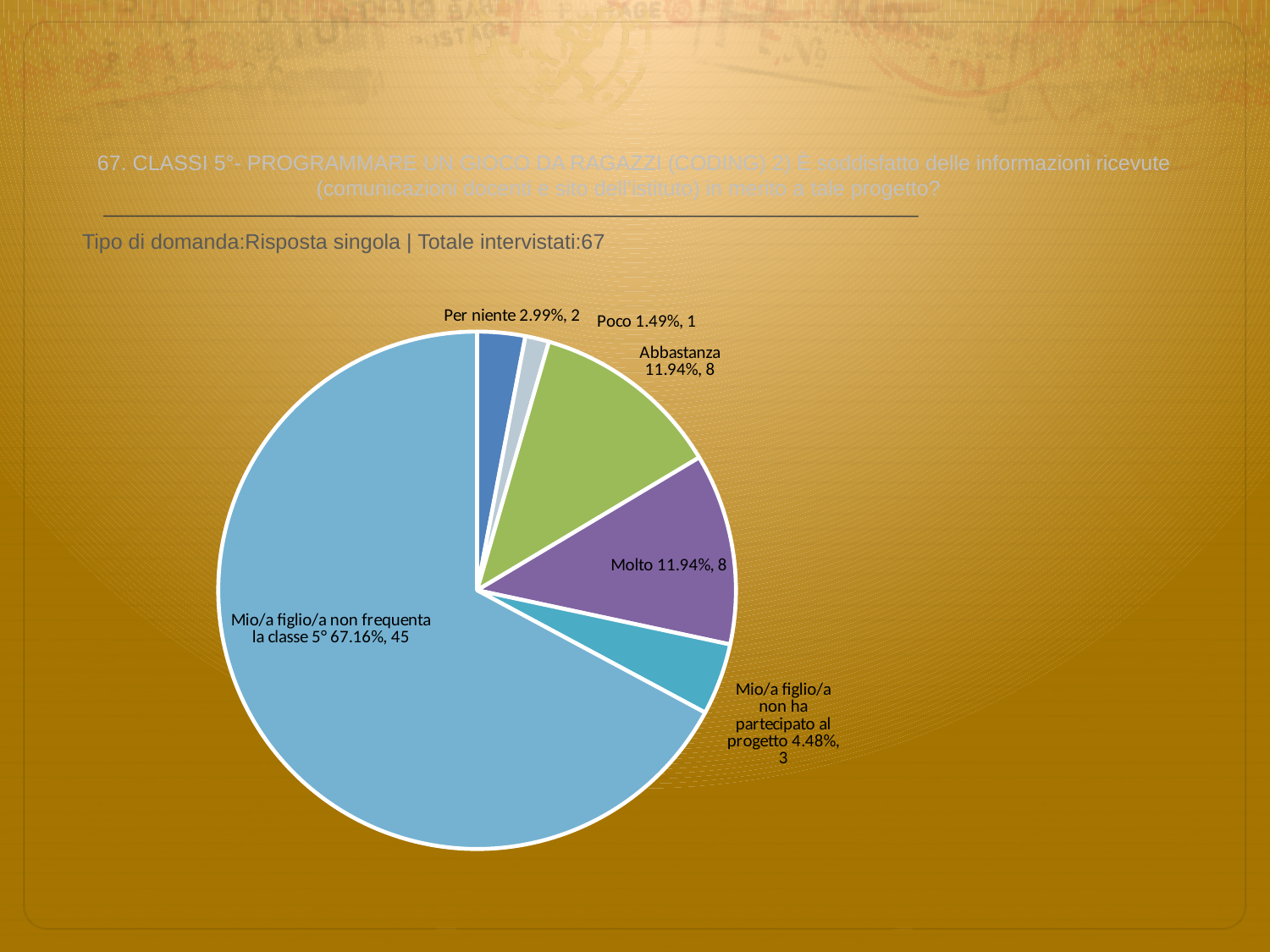
Which has a larger count, "Per niente" or "Mio/a figlio/a non ha partecipato al progetto"? Mio/a figlio/a non ha partecipato al progetto Which category has the smallest slice in the pie chart? Poco Which category has the largest slice in the pie chart? Mio/a figlio/a non frequenta la classe 5° What percentage share does "Mio/a figlio/a non ha partecipato al progetto" have? 4.48% How many slices does the pie chart have? 6 What kind of chart is shown on the slide? pie chart What is the total number of respondents (Totale intervistati) stated on the slide? 67 What percentage share does "Molto" have in the pie chart? 11.94% What is the difference in count between "Mio/a figlio/a non frequenta la classe 5°" and "Molto"? 37 What is the count for "Poco" in the pie chart? 1 What percentage share does "Per niente" have in the pie chart? 2.99% What is the count for "Abbastanza" in the pie chart? 8